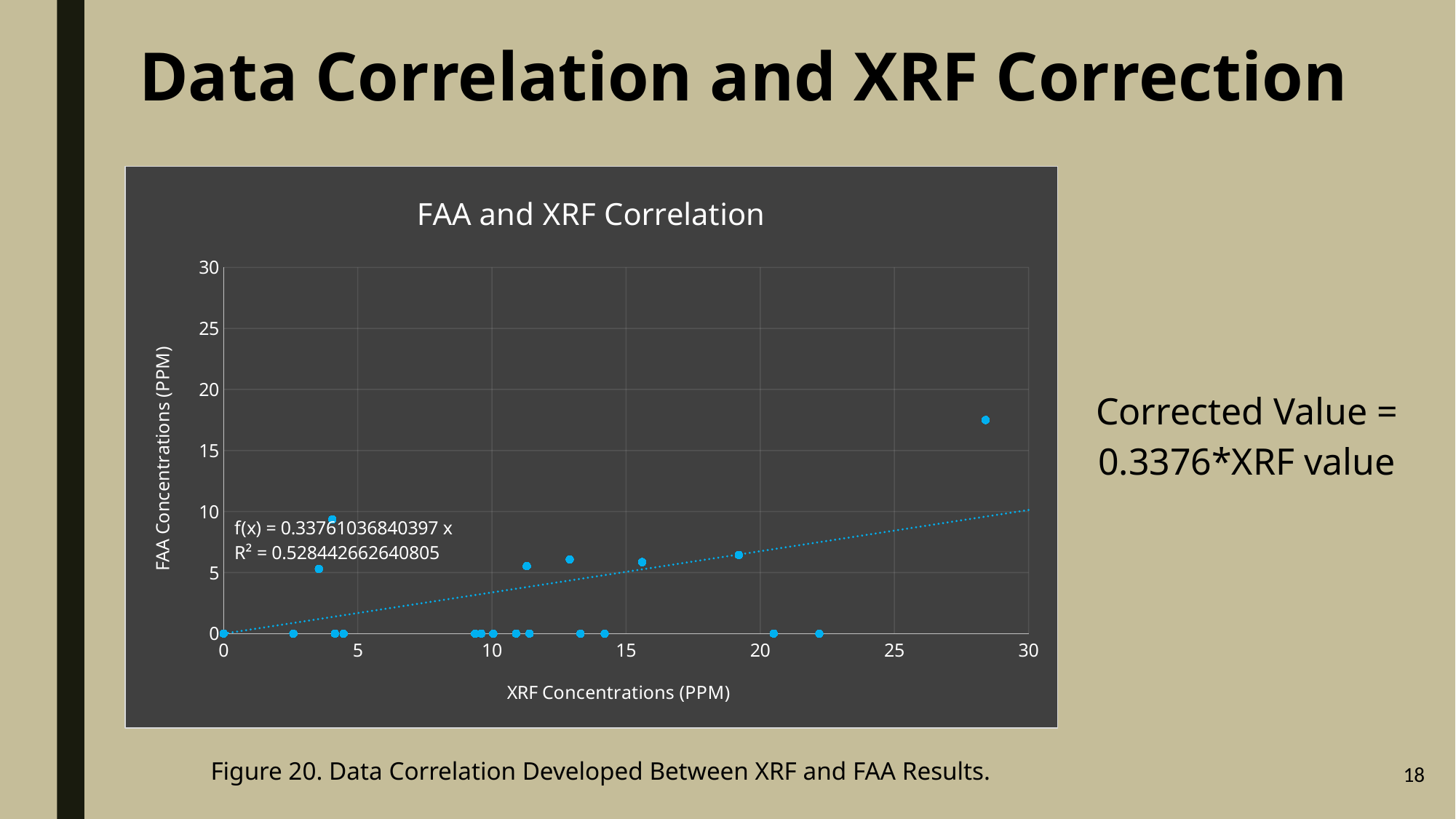
Is the FAA concentration of the point with the highest XRF concentration greater or less than 20? less What R² value is printed on the chart? 0.528442662640805 What is the trendline equation printed on the chart? f(x) = 0.33761036840397 x What is the label of the x axis of the chart? XRF Concentrations (PPM) What is the maximum value shown on the y axis of the chart? 30 Is the highest FAA concentration plotted on the chart greater or less than 15? greater Does the trendline on the chart rise or fall as XRF concentration increases? Rises Is the FAA concentration of the point at an XRF concentration of about 19 greater or less than 10? less What kind of chart is shown on the slide? Scatter chart What is the title of the chart? FAA and XRF Correlation What is the maximum value shown on the x axis of the chart? 30 Which has the higher FAA concentration: the point at an XRF concentration of about 28 or the point at about 15.5? The point at about 28